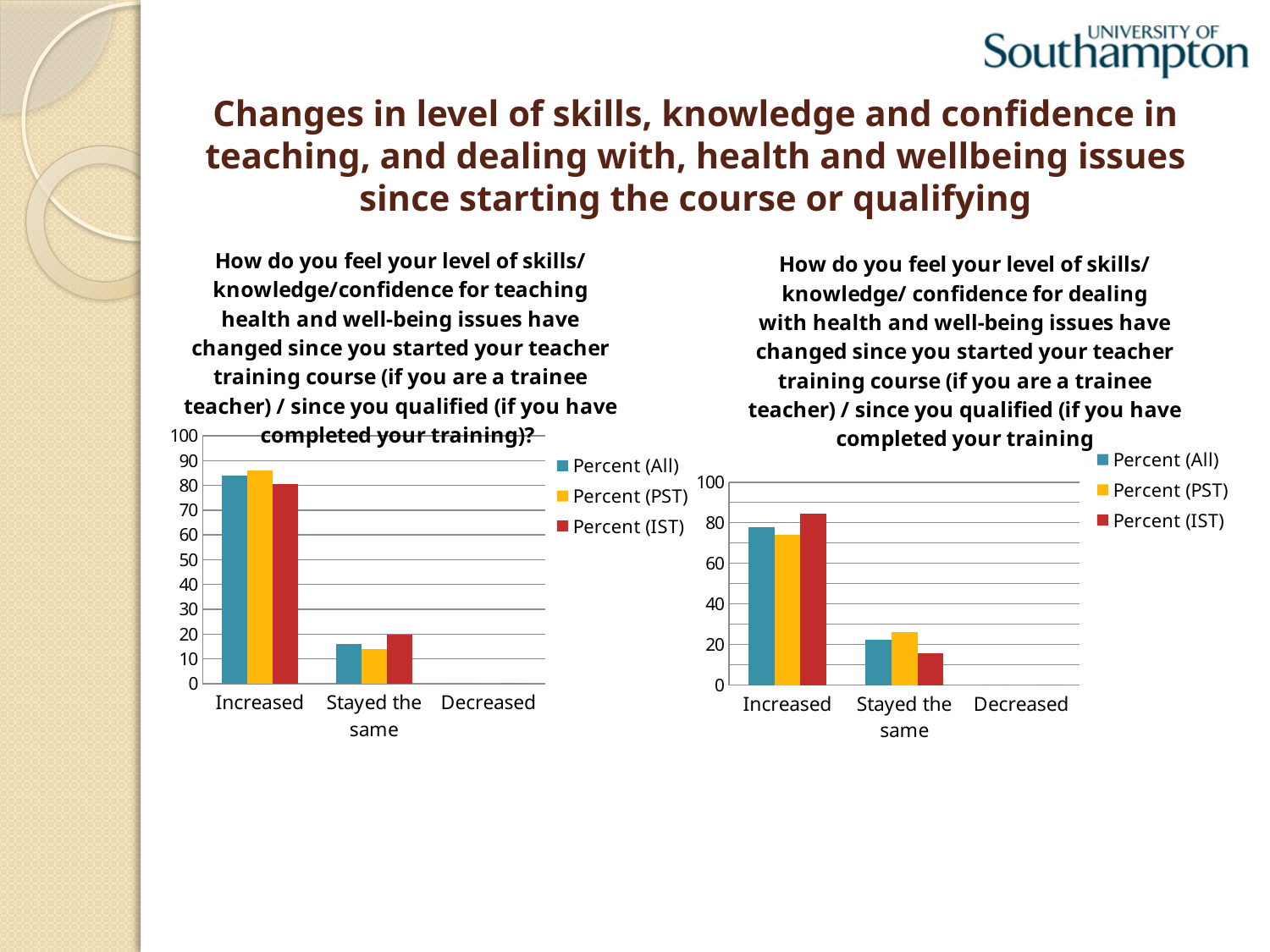
In the right chart, is the Percent (PST) value for Stayed the same greater or less than 20? greater In the left chart, do the Percent (All) values rise or fall from Increased to Decreased along the x axis? fall What kind of chart is the left chart on the slide? bar chart How many categories are shown on the x axis of the left chart? 3 In the right chart, which series has the larger value for Increased: Percent (PST) or Percent (IST)? Percent (IST) In the right chart, which category has the highest Percent (All) value? Increased How many series does the legend of the right chart list? 3 Which colour represents Percent (PST) in the legend of the right chart? yellow In the left chart, which category has the lowest Percent (PST) value? Decreased In the left chart, is the Percent (All) value for Increased greater or less than 80? greater In the left chart, is the Percent (IST) value for Stayed the same greater or less than 30? less